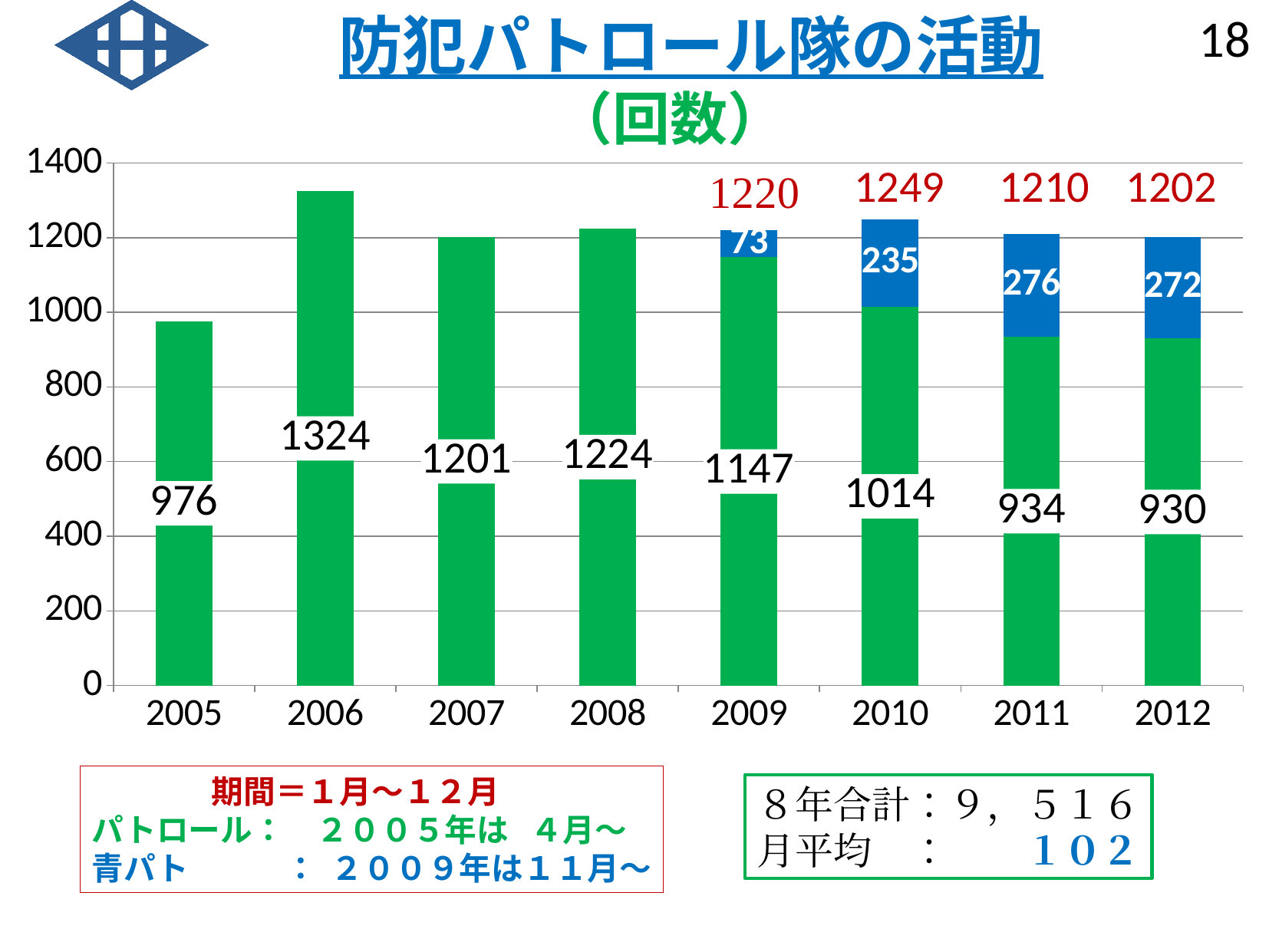
Is the value for 2005 greater or less than 1000? less What is the difference between the green (パトロール) values for 2008 and 2007? 23 What kind of chart is shown on the slide? Stacked bar chart Which year has the highest green (パトロール) value? 2006 What is the value of the blue (青パト) segment for 2010? 235 Which year has the lowest green (パトロール) value? 2012 What is the value of the green (パトロール) segment for 2006? 1324 Which year has the larger blue (青パト) value, 2011 or 2012? 2011 Do the green (パトロール) values rise or fall from 2008 to 2012? fall What is the total of the stacked bar for 2011? 1210 How many years are shown on the x axis? 8 Which year has the highest stacked bar total? 2006